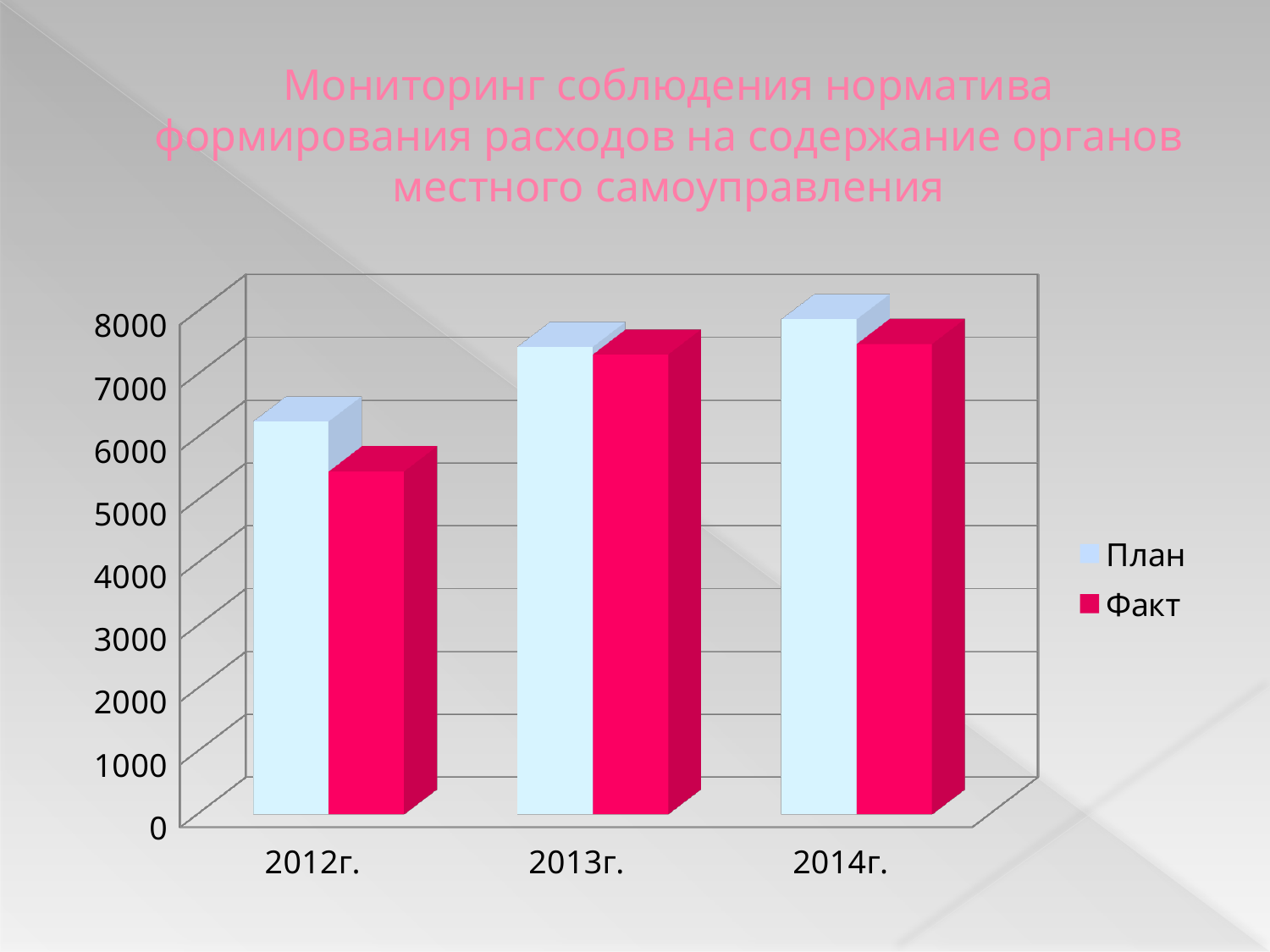
Is the value for Факт in 2012г. greater or less than 6000? less How many series does the legend list? 2 In which year is the Факт value lowest? 2012г. Which is larger in 2014г., План or Факт? План Is the value for План in 2013г. greater or less than 7000? greater In which year is the План value highest? 2014г. How many year categories are shown on the x axis? 3 Is the value for Факт in 2012г. greater or less than 5000? greater Which is larger in 2012г., План or Факт? План What kind of chart is shown on the slide? bar chart Which series does the legend list first? План